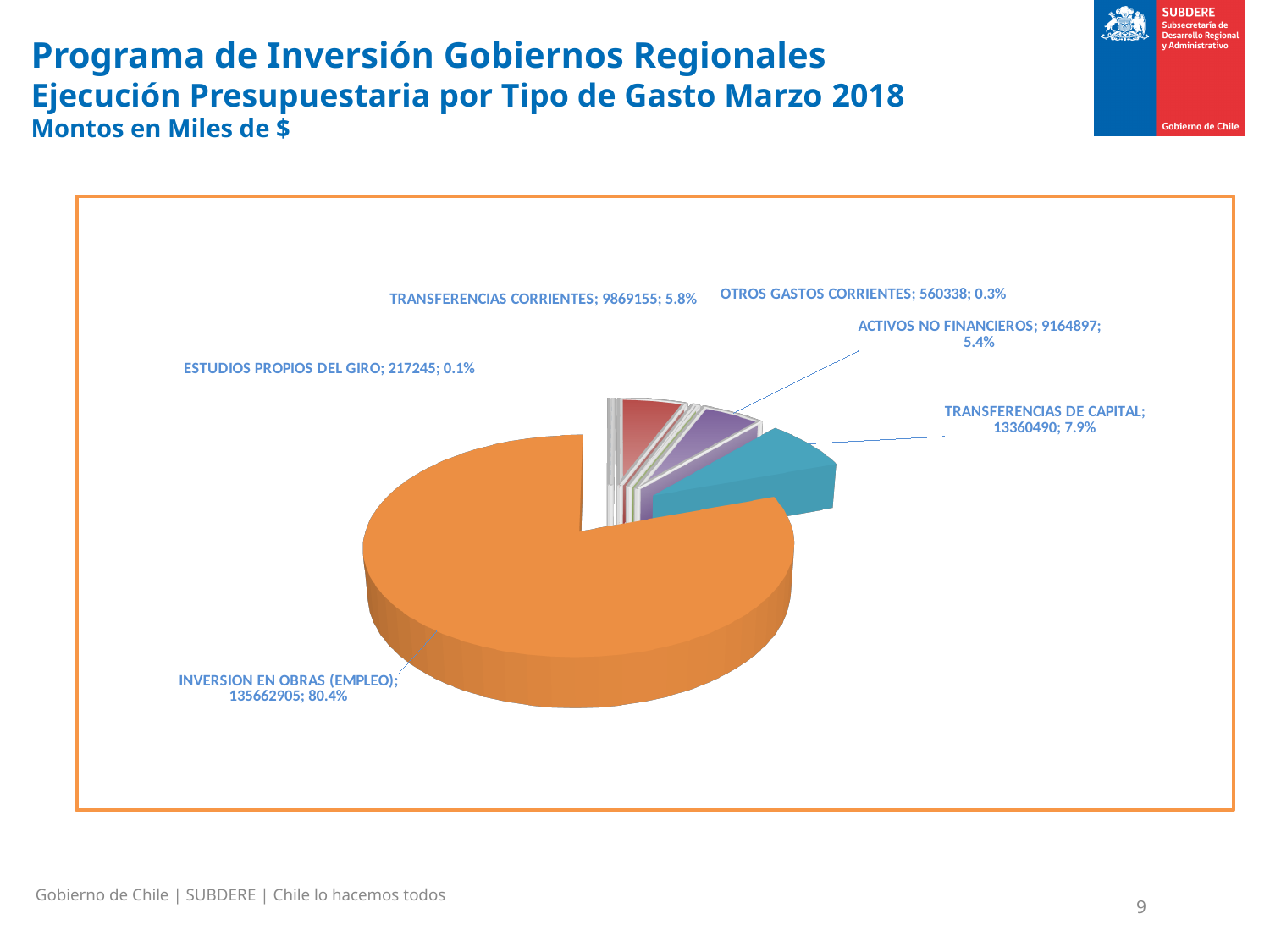
What share of the pie does ESTUDIOS PROPIOS DEL GIRO represent? 0.1% What share of the pie does INVERSION EN OBRAS (EMPLEO) represent? 80.4% Which is larger, the value for TRANSFERENCIAS DE CAPITAL or the value for TRANSFERENCIAS CORRIENTES? TRANSFERENCIAS DE CAPITAL What is the value for OTROS GASTOS CORRIENTES? 560338 What share of the pie does TRANSFERENCIAS DE CAPITAL represent? 7.9% Which category has the smallest slice of the pie? ESTUDIOS PROPIOS DEL GIRO Which category has the largest slice of the pie? INVERSION EN OBRAS (EMPLEO) What is the value for ACTIVOS NO FINANCIEROS? 9164897 What is the value for INVERSION EN OBRAS (EMPLEO)? 135662905 What is the difference between the values for TRANSFERENCIAS CORRIENTES and ACTIVOS NO FINANCIEROS? 704258 What kind of chart is shown on the slide? Pie chart How many categories are shown in the pie chart? 6